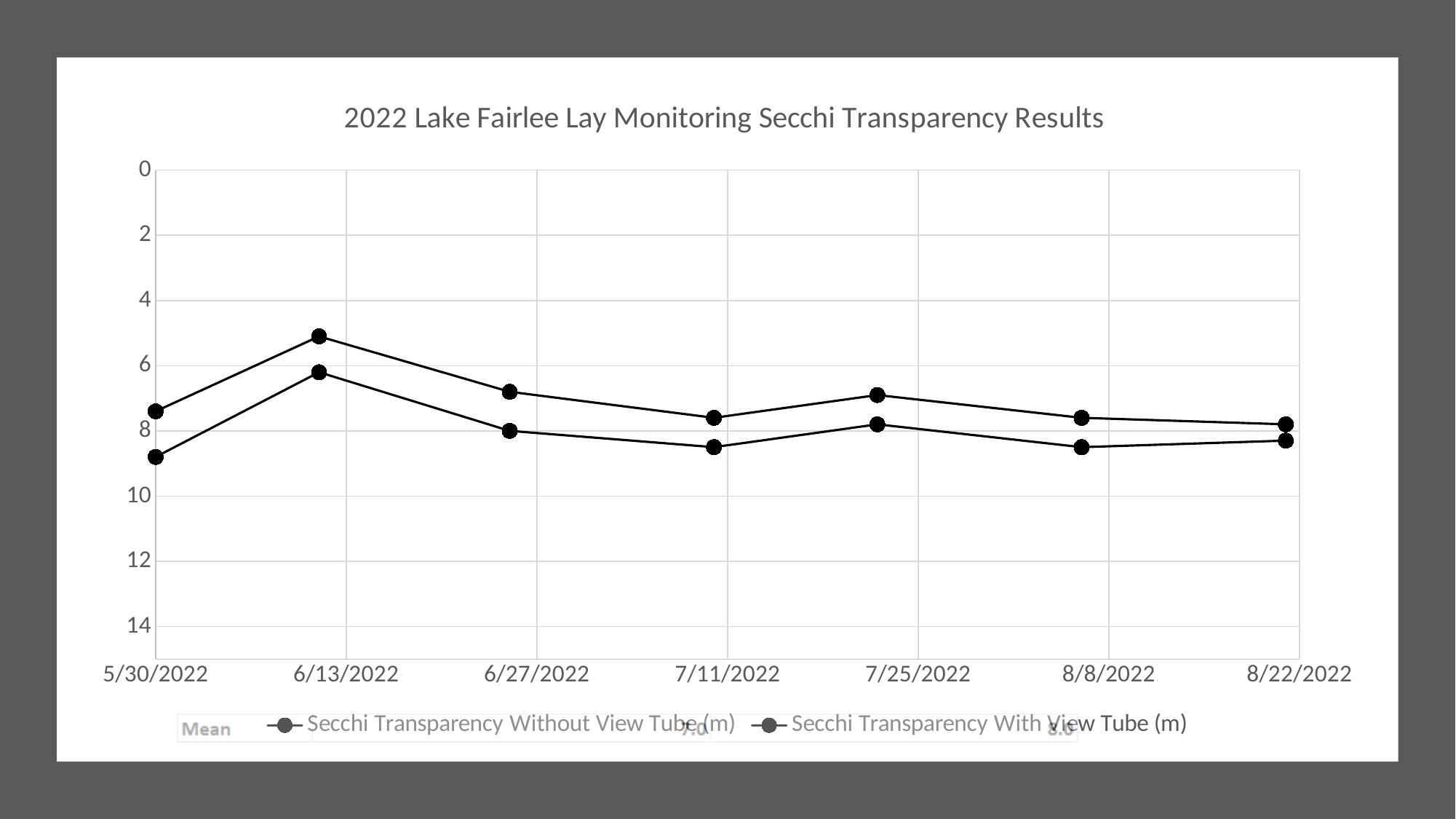
What is the title of the chart? 2022 Lake Fairlee Lay Monitoring Secchi Transparency Results What are the two series named in the legend? Secchi Transparency Without View Tube (m) and Secchi Transparency With View Tube (m) How many dates are plotted along the x axis? 7 For both series, which date has the smaller value: 6/13/2022 or 6/27/2022? 6/13/2022 Are the values for both series on 5/30/2022 greater or less than 6? greater How many series does the legend list? 2 Between 6/13/2022 and 7/11/2022, do the plotted values for both series increase or decrease? increase Are the values for both series on 6/13/2022 greater or less than 8? less Are the values for both series on 7/11/2022 greater or less than 10? less What type of chart is shown on the slide? Line chart Between 5/30/2022 and 6/13/2022, do the plotted values for both series increase or decrease? decrease Which date has the lowest Secchi transparency value for both series? 6/13/2022